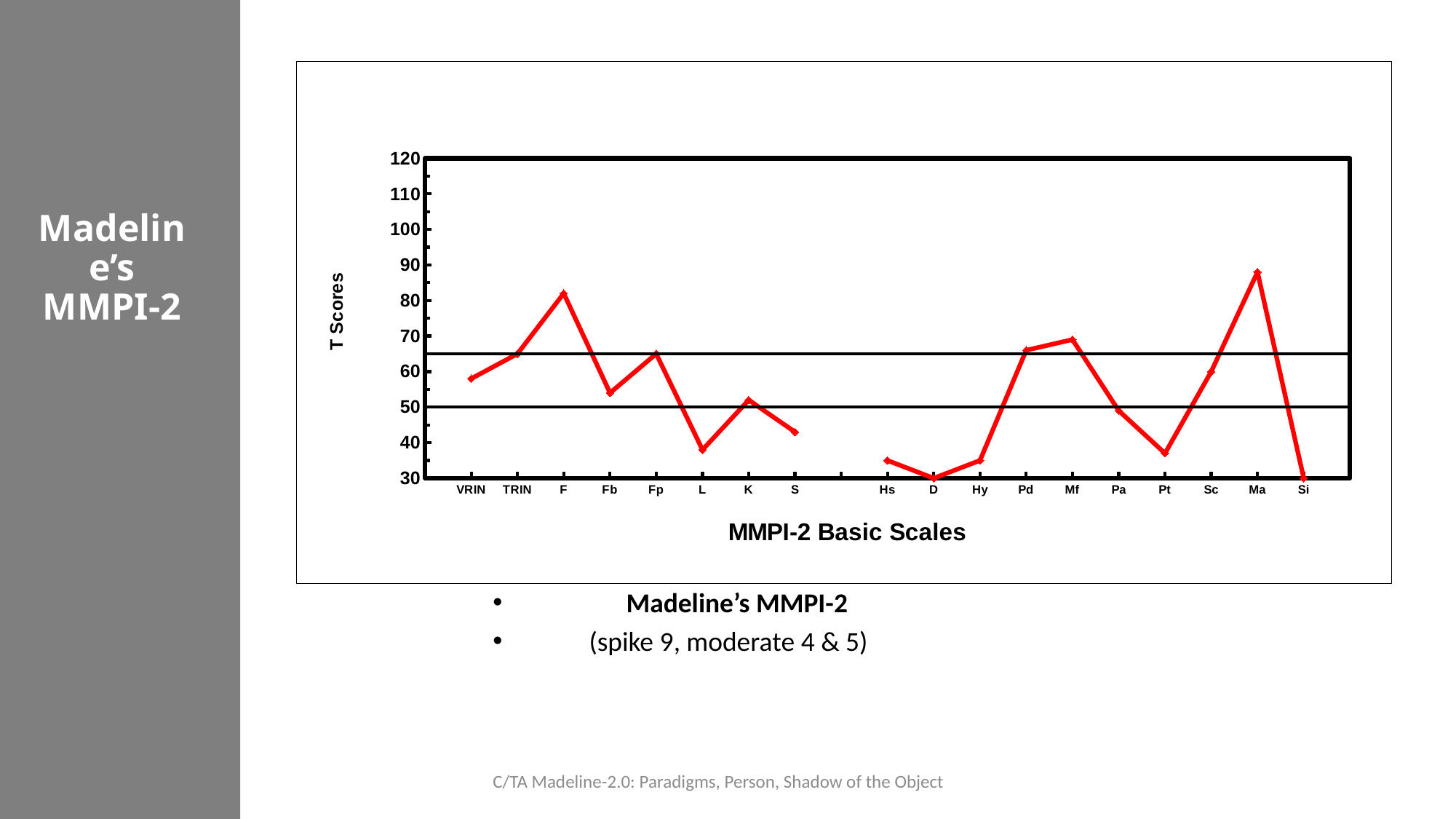
Is the value for Ma greater or less than 80? greater What is the title of the y axis of the chart? T Scores What kind of chart is shown on the slide? line chart Which scale has the highest T score on the chart? Ma Is the value for Hs greater or less than 40? less Is the value for F greater or less than 70? greater Which has the higher T score, Pd or Pa? Pd Do the values rise or fall from Pt to Ma? rise Which has the higher T score, F or Fb? F How many scales are labeled on the x axis of the chart? 18